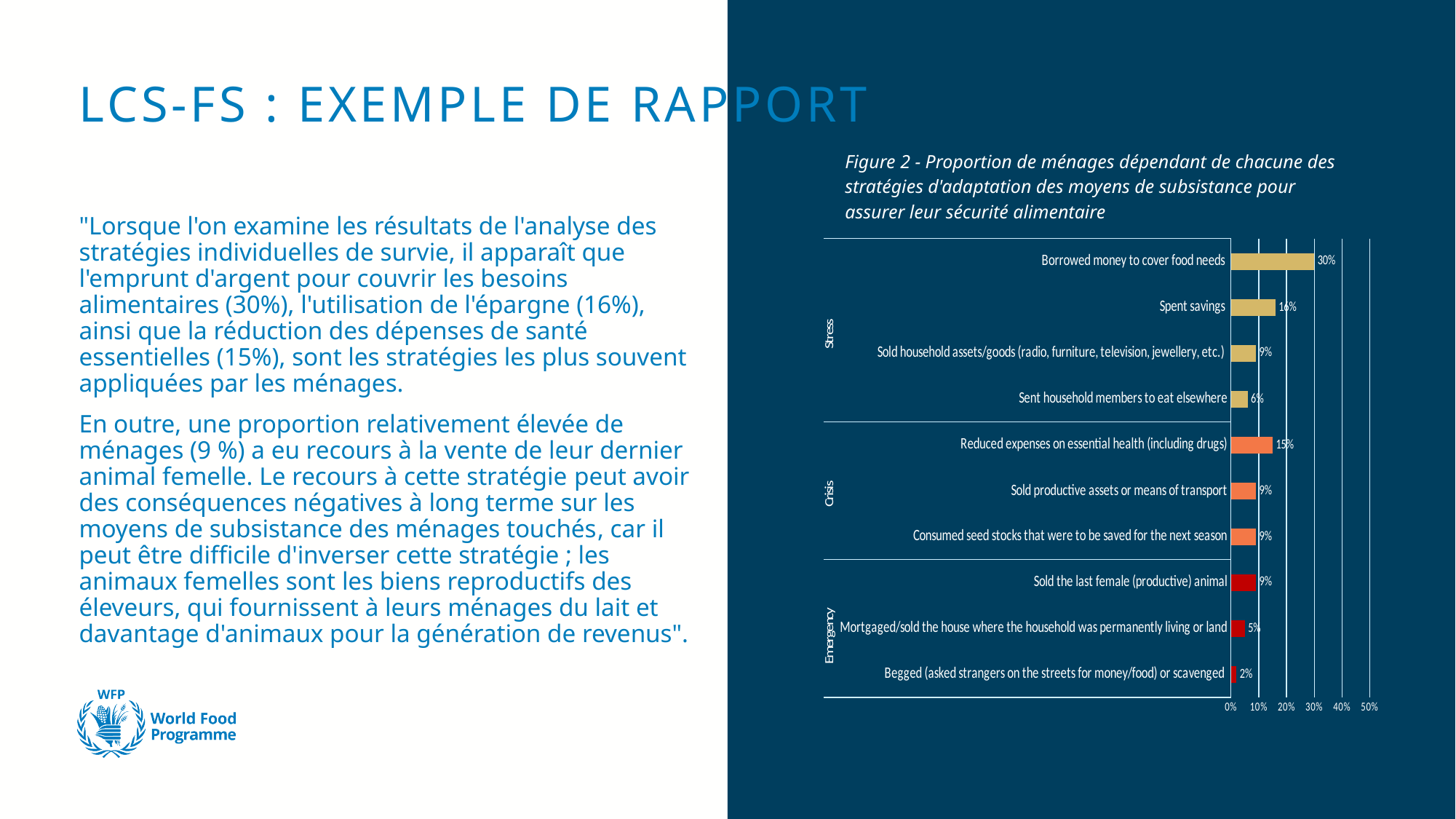
Which strategy has the highest proportion of households? Borrowed money to cover food needs Which strategy has the lowest proportion of households? Begged (asked strangers on the streets for money/food) or scavenged What are the three group labels shown along the left side of the chart? Stress, Crisis, Emergency What is the value for "Reduced expenses on essential health (including drugs)"? 15% What kind of chart is shown on the slide? bar chart What is the value for "Begged (asked strangers on the streets for money/food) or scavenged"? 2% What is the value for "Spent savings"? 16% What is the value for "Sent household members to eat elsewhere"? 6% Which is larger: the value for "Spent savings" or the value for "Reduced expenses on essential health (including drugs)"? Spent savings What is the difference between the values for "Borrowed money to cover food needs" and "Spent savings"? 14% What is the value for "Borrowed money to cover food needs"? 30% How many strategies (bars) are plotted in the chart? 10